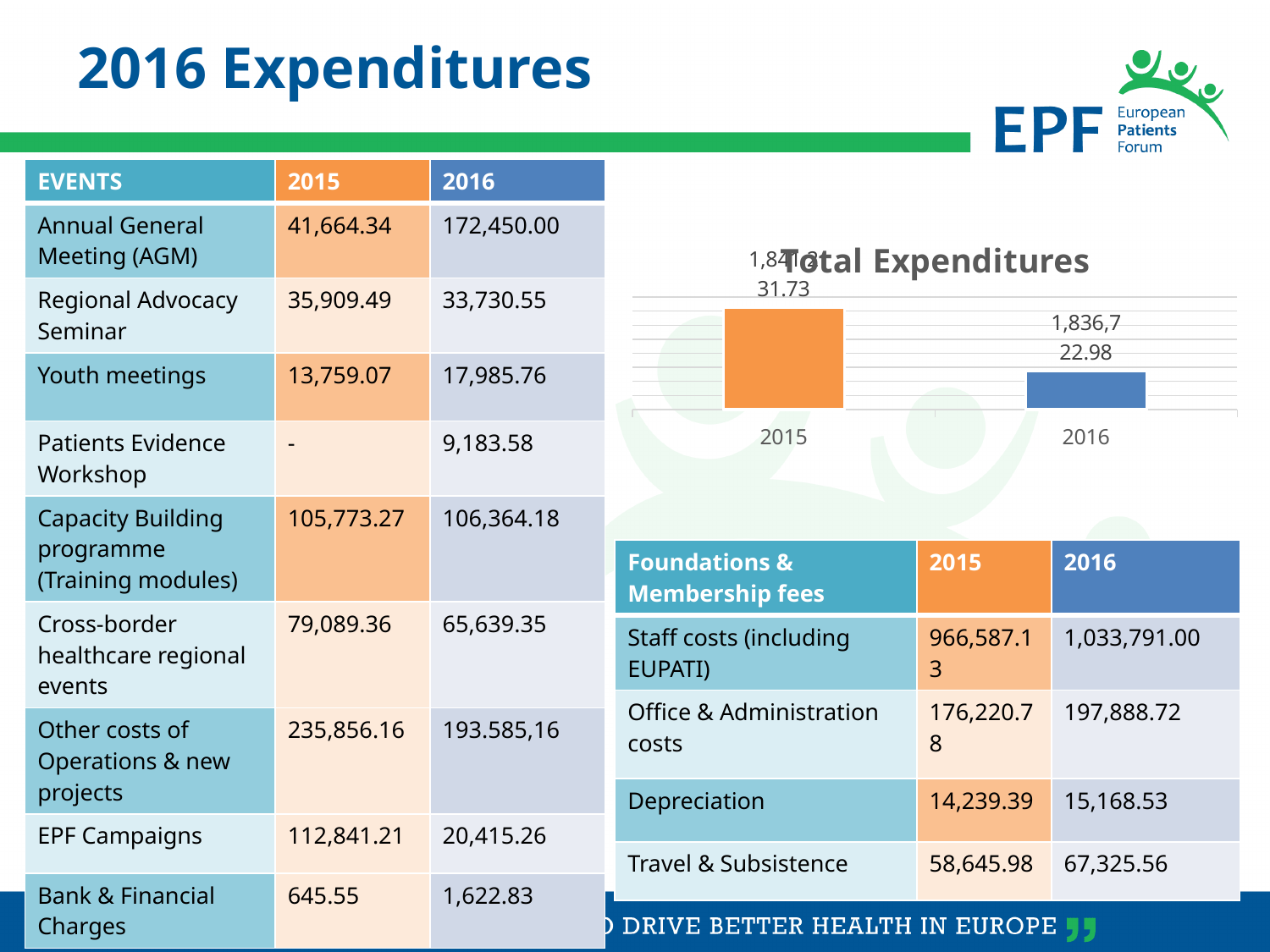
In the Total Expenditures chart, which year has the lower total expenditure? 2016 What type of chart is the Total Expenditures chart? bar chart Do total expenditures rise or fall from 2015 to 2016 in the Total Expenditures chart? fall What is the title of the chart on the slide? Total Expenditures In the Total Expenditures chart, is the bar for 2015 taller or shorter than the bar for 2016? taller Which years are shown on the x axis of the Total Expenditures chart? 2015 and 2016 In the Total Expenditures chart, what is the value for 2016? 1,836,722.98 In the Total Expenditures chart, which year has the higher total expenditure? 2015 How many bars are shown in the Total Expenditures chart? 2